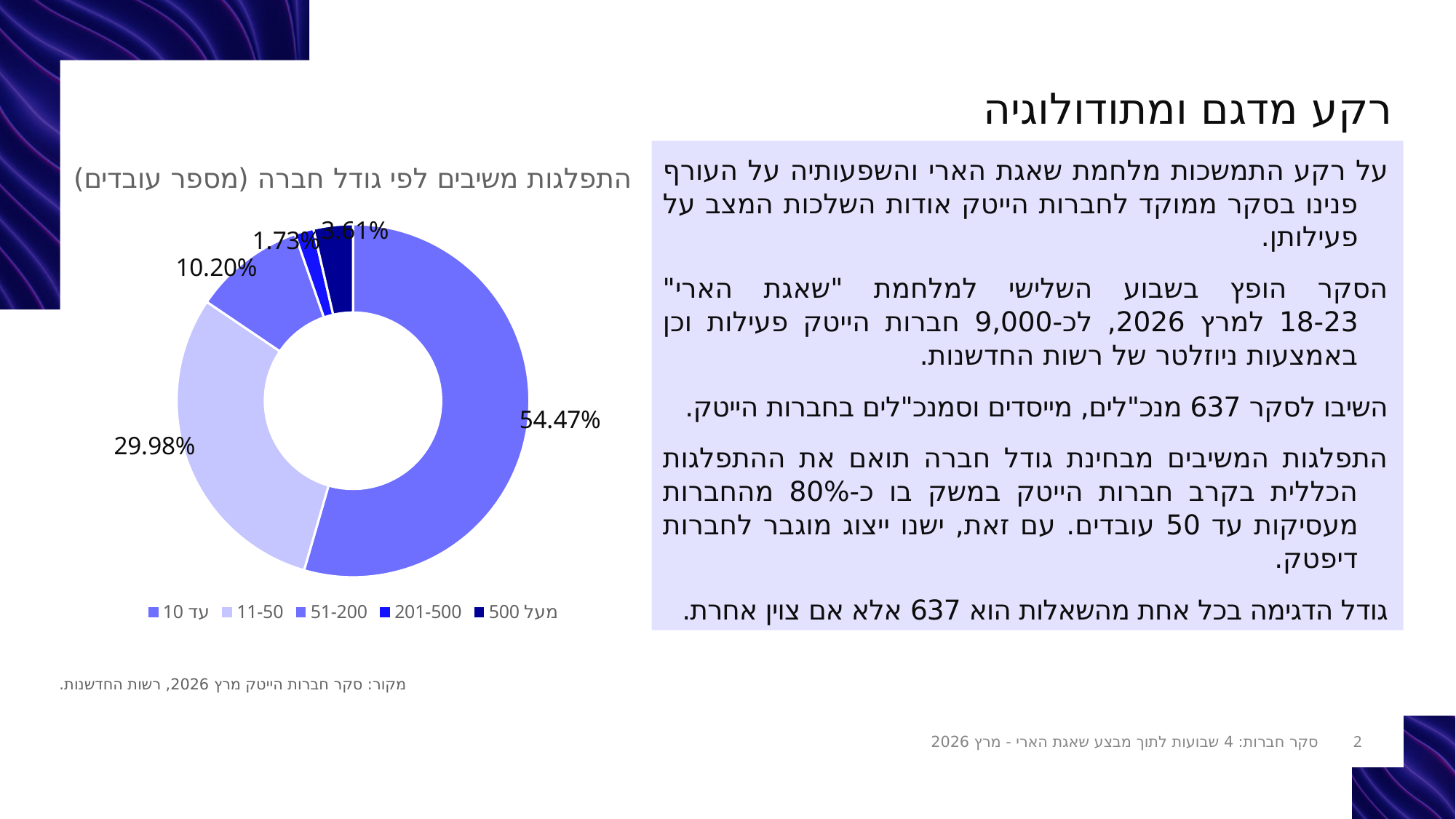
What share of respondents are from companies with over 500 employees (מעל 500)? 3.61% What share of respondents are from companies with 11-50 employees? 29.98% What is the title of the chart? התפלגות משיבים לפי גודל חברה (מספר עובדים) How many company-size categories does the legend list? 5 Which company-size category has the smallest share of respondents? 201-500 Which company-size category has the largest share of respondents? עד 10 What share of respondents are from companies with up to 10 employees (עד 10)? 54.47% What is the difference in percentage points between the עד 10 and 11-50 categories? 24.49 What share of respondents are from companies with 201-500 employees? 1.73% What share of respondents are from companies with 51-200 employees? 10.20% What kind of chart is shown on the slide? Donut (pie) chart Which has a larger share of respondents: 51-200 or מעל 500? 51-200